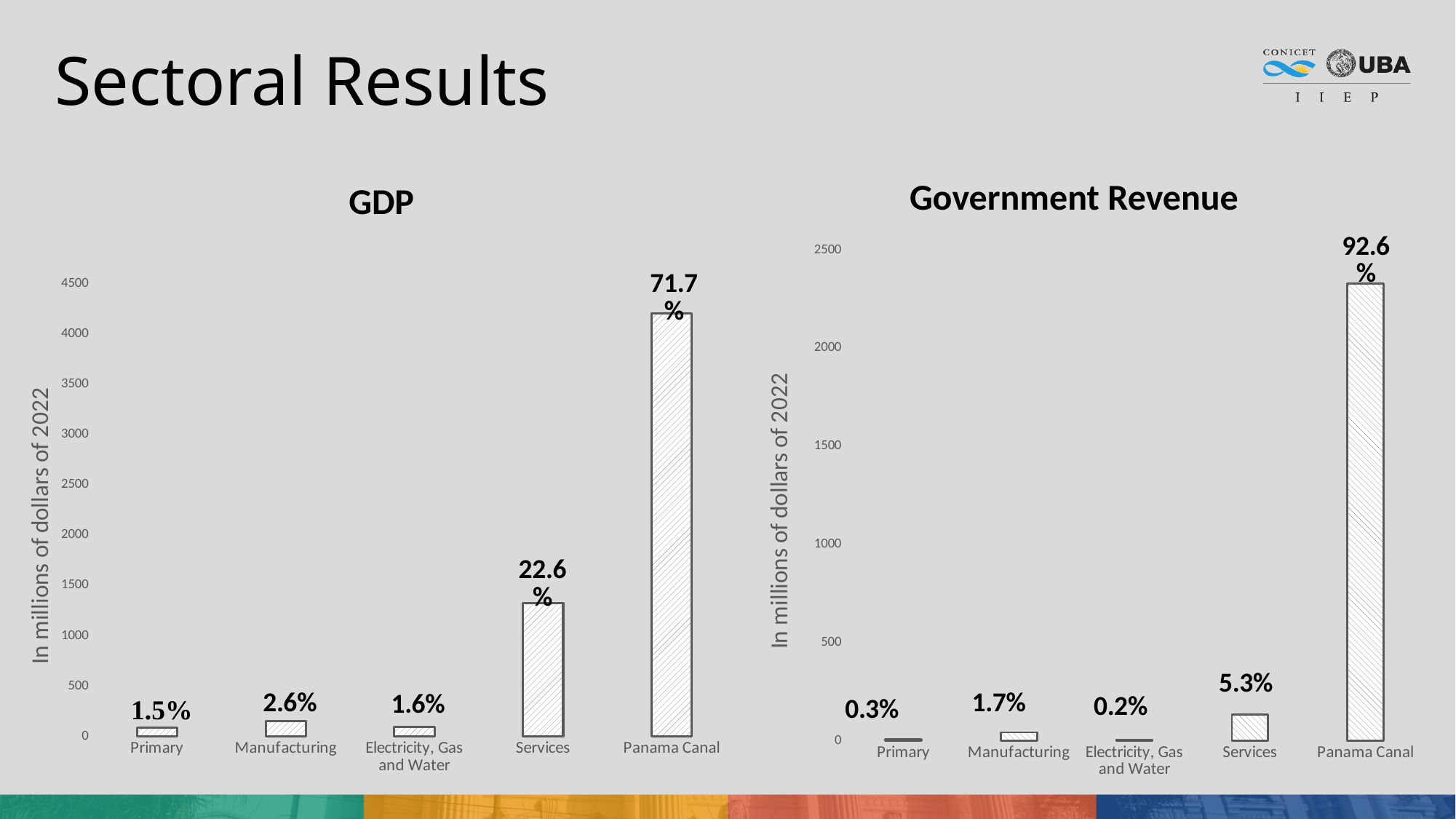
In the Government Revenue chart, which is larger, Services or Manufacturing? Services In the Government Revenue chart, is the value for Panama Canal greater or less than 2000? greater What kind of chart is the Government Revenue chart? bar chart In the GDP chart, which category has the highest value? Panama Canal What is the y-axis label of the GDP chart? In millions of dollars of 2022 In the GDP chart, is the value for Services greater or less than 1500? less In the GDP chart, is the value for Panama Canal greater or less than 4000? greater In the Government Revenue chart, what percentage label is shown for Manufacturing? 1.7% In the Government Revenue chart, what percentage label is shown for Panama Canal? 92.6% How many categories are shown in the GDP chart? 5 In the GDP chart, what percentage label is shown for Services? 22.6% In the GDP chart, what is the difference in percentage points between the Panama Canal label and the Services label? 49.1